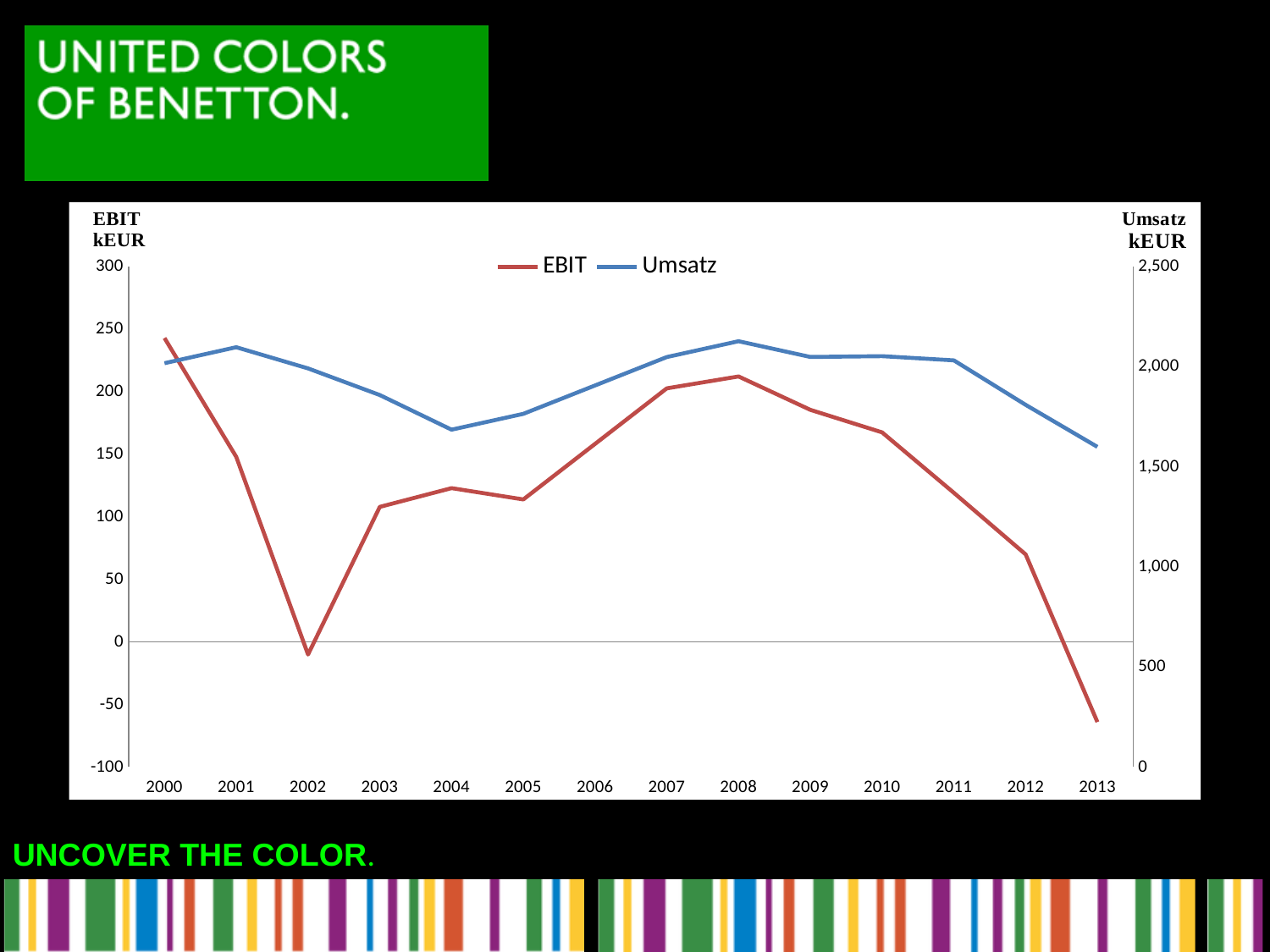
What is the label of the right-hand vertical axis? Umsatz kEUR Is the Umsatz value for 2013 greater or less than 2,000? less In which year is Umsatz at its lowest? 2013 How many series does the legend list? 2 In which year is EBIT at its lowest? 2013 Is the EBIT value for 2000 greater or less than 200? greater In which year is EBIT at its highest? 2000 Which year has the higher EBIT, 2004 or 2007? 2007 What kind of chart is shown on the slide? line chart How many years are plotted along the x axis? 14 Does EBIT rise or fall from 2008 to 2013? fall Is the EBIT value for 2013 greater or less than -50? less